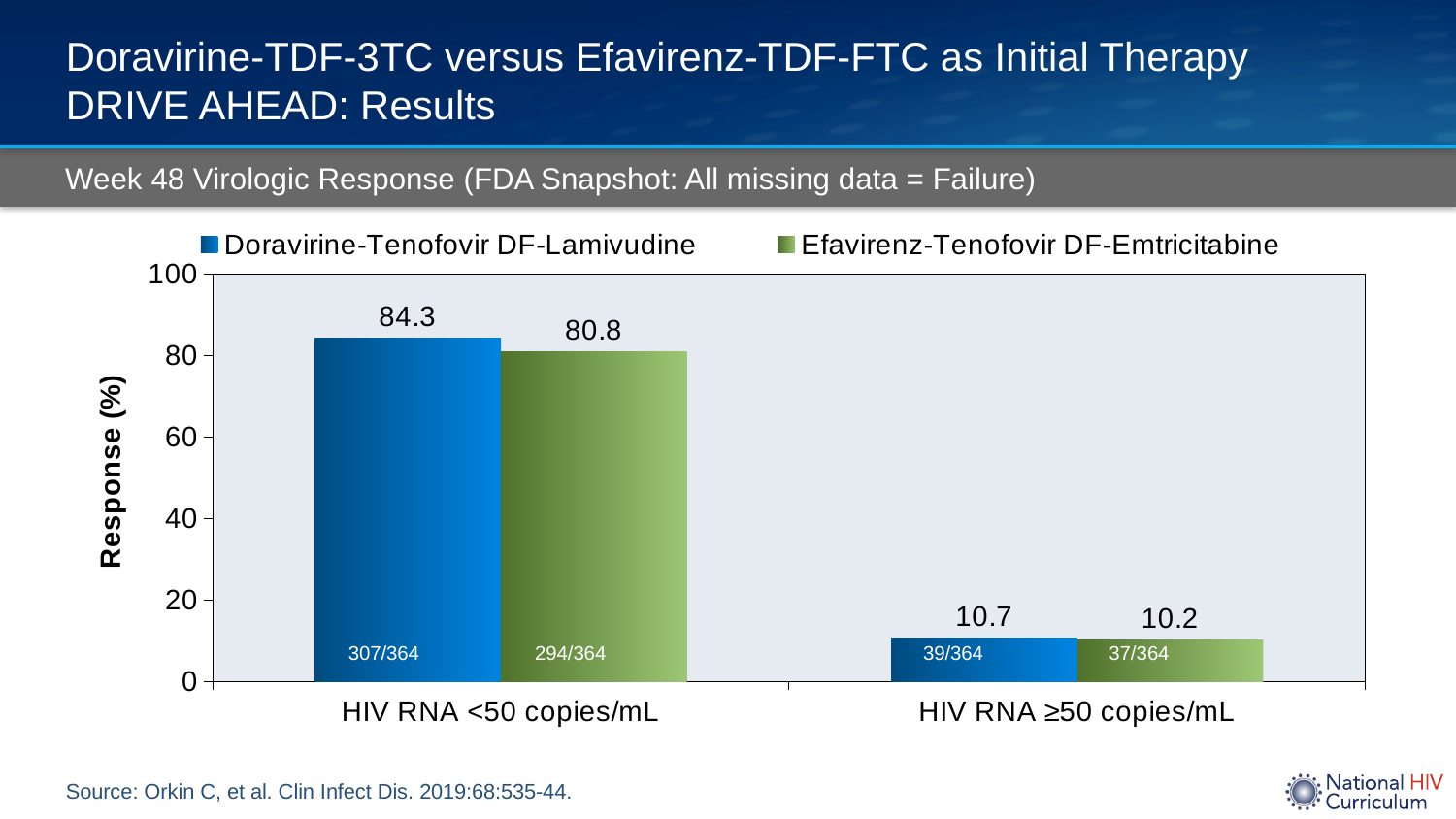
Which category has the highest response (%) for Doravirine-Tenofovir DF-Lamivudine? HIV RNA <50 copies/mL What is the response (%) for Efavirenz-Tenofovir DF-Emtricitabine in the HIV RNA <50 copies/mL category? 80.8 What kind of chart is shown on the slide? Bar chart What is the response (%) for Efavirenz-Tenofovir DF-Emtricitabine in the HIV RNA ≥50 copies/mL category? 10.2 What is the difference in response (%) between Doravirine-Tenofovir DF-Lamivudine and Efavirenz-Tenofovir DF-Emtricitabine in the HIV RNA <50 copies/mL category? 3.5 What fraction is printed inside the Doravirine-Tenofovir DF-Lamivudine bar for HIV RNA <50 copies/mL? 307/364 What is the response (%) for Doravirine-Tenofovir DF-Lamivudine in the HIV RNA <50 copies/mL category? 84.3 How many categories are shown on the x axis? 2 How many series does the legend list? 2 Which series has the higher response (%) in the HIV RNA <50 copies/mL category? Doravirine-Tenofovir DF-Lamivudine What fraction is printed inside the Efavirenz-Tenofovir DF-Emtricitabine bar for HIV RNA ≥50 copies/mL? 37/364 What is the response (%) for Doravirine-Tenofovir DF-Lamivudine in the HIV RNA ≥50 copies/mL category? 10.7